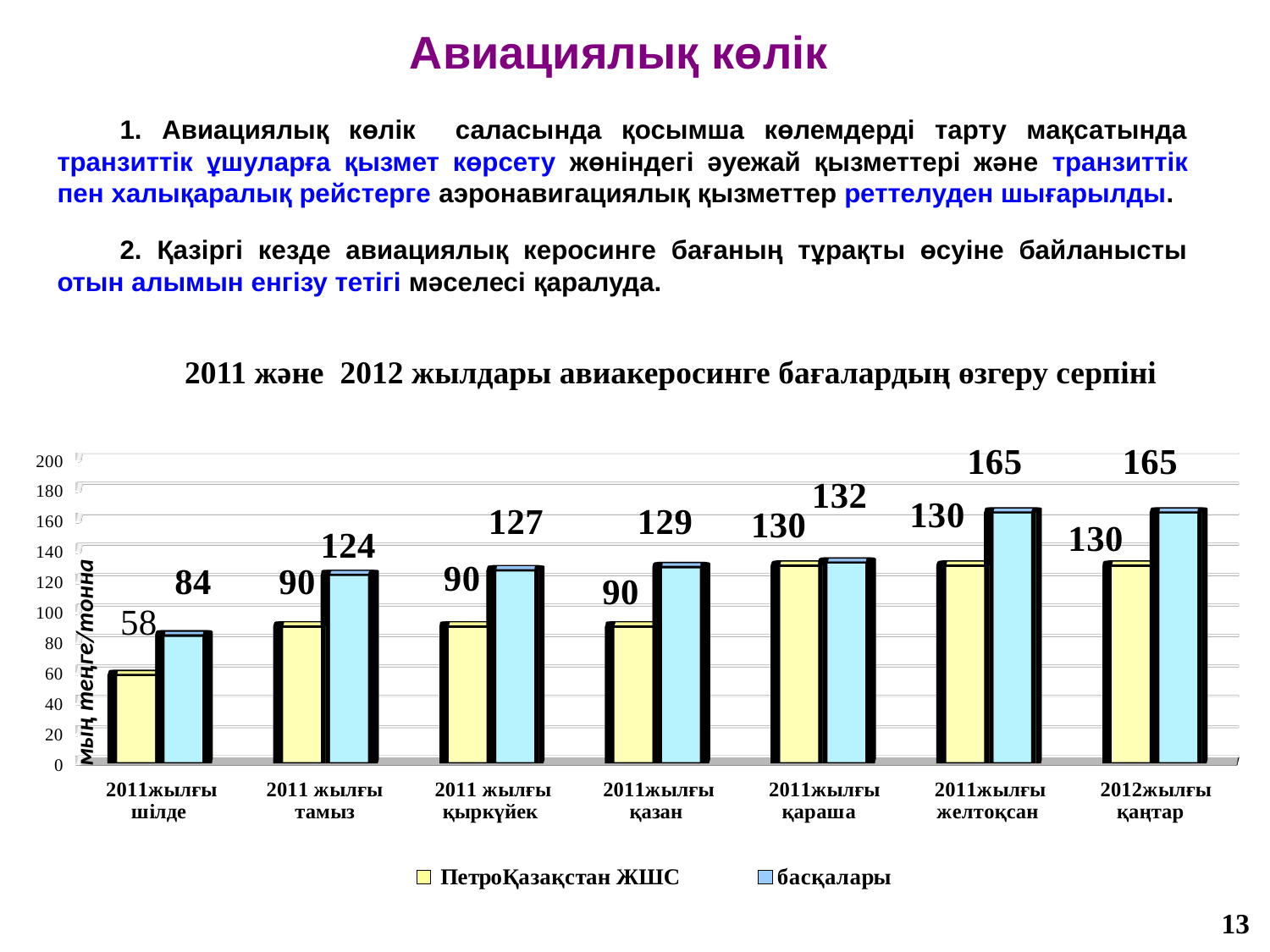
What is the value for ПетроҚазақстан ЖШС in 2011 жылғы шілде? 58 What is the value for басқалары in 2011 жылғы қазан? 129 Which is larger in 2011 жылғы қараша: ПетроҚазақстан ЖШС or басқалары? басқалары What kind of chart is shown on the slide? bar chart Do the values for басқалары rise or fall from 2011 жылғы шілде to 2012 жылғы қаңтар? rise How many month categories are shown on the x axis of the chart? 7 What is the value for басқалары in 2011 жылғы тамыз? 124 What is the title of the chart? 2011 және 2012 жылдары авиакеросинге бағалардың өзгеру серпіні What is the value for ПетроҚазақстан ЖШС in 2012 жылғы қаңтар? 130 In which month is the value for басқалары the lowest? 2011 жылғы шілде How many series does the chart legend list? 2 What is the difference between басқалары and ПетроҚазақстан ЖШС in 2011 жылғы желтоқсан? 35